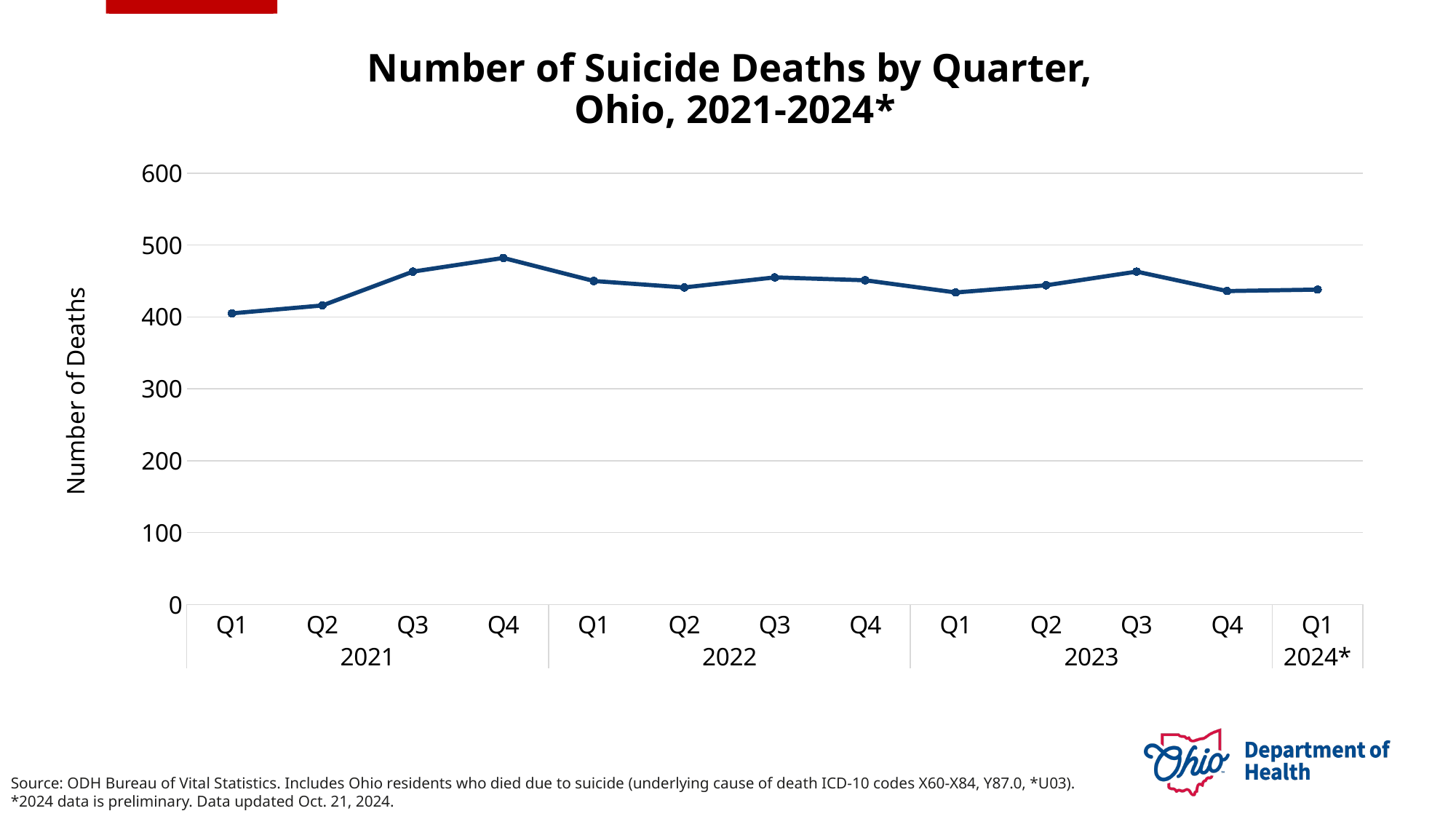
How many quarterly data points are plotted on the chart? 13 Is the value for Q3 2023 greater or less than 500? less Which quarter has the lowest number of suicide deaths? Q1 2021 Which is larger, the value for Q1 2021 or the value for Q3 2021? Q3 2021 What is the label on the vertical axis? Number of Deaths Which quarter has the highest number of suicide deaths? Q4 2021 Is the value for Q1 2021 greater or less than 500? less Which is larger, the value for Q4 2021 or the value for Q1 2023? Q4 2021 Do the values rise or fall from Q1 2021 to Q4 2021? Rise What kind of chart is shown on the slide? Line chart Is the value for Q4 2021 greater or less than 400? greater What is the title of the chart? Number of Suicide Deaths by Quarter, Ohio, 2021-2024*